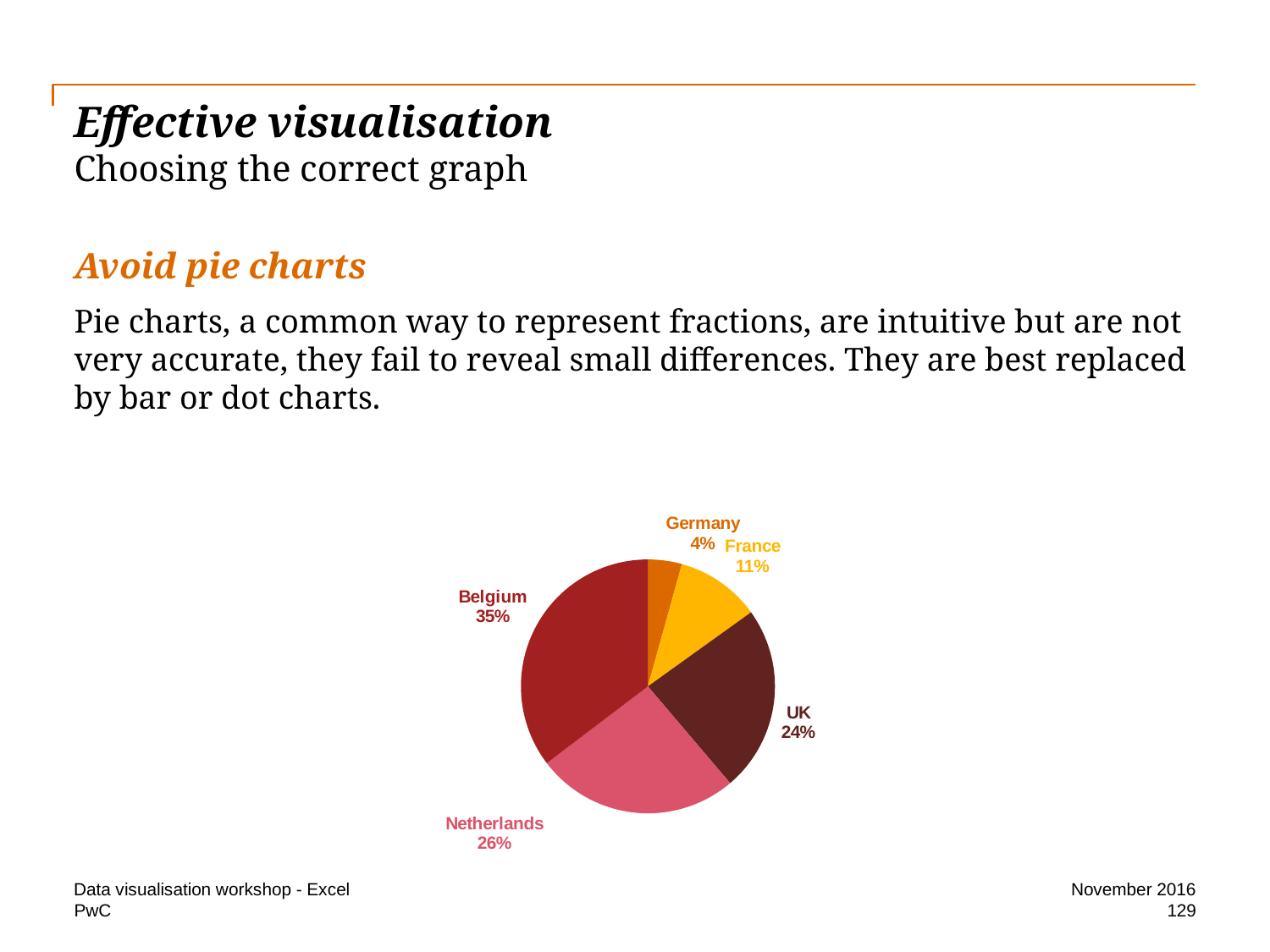
What share of the pie does Belgium have? 35% What is the difference between the Belgium and UK shares? 11% How many slices does the pie chart have? 5 What is the combined share of the Netherlands and the UK? 50% What kind of chart is shown on the slide? pie chart Which is larger, the share for France or the share for Germany? France What is the value shown for the UK slice? 24% Which country has the largest slice of the pie? Belgium What is the value shown for Germany? 4% What is the value shown for the Netherlands? 26% Which country has the smallest slice of the pie? Germany What is the value shown for France? 11%